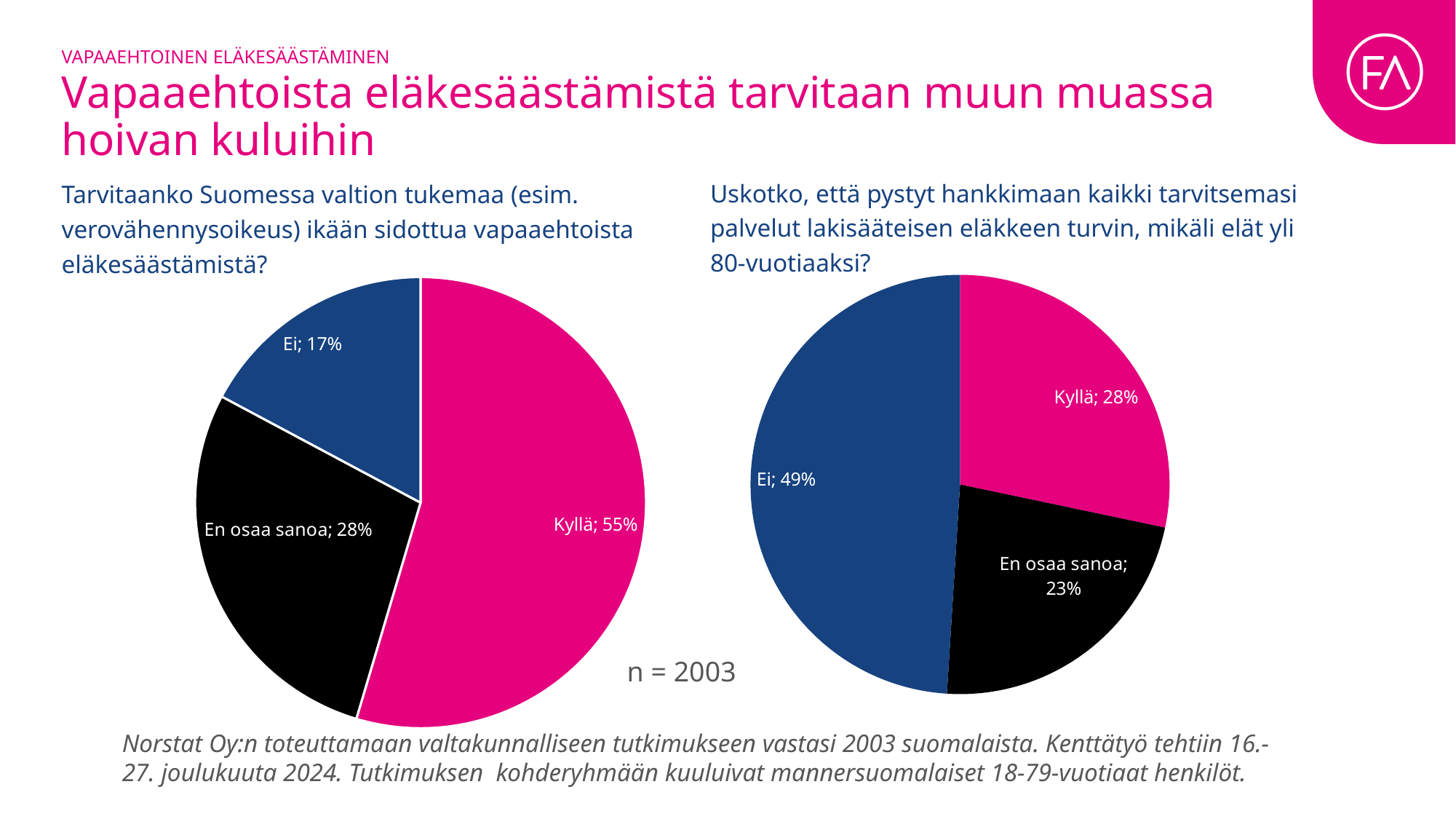
In the right pie chart (Uskotko, että pystyt hankkimaan kaikki tarvitsemasi palvelut...), what share answered Ei? 49% In the left pie chart (Tarvitaanko Suomessa valtion tukemaa... eläkesäästämistä?), what share answered Kyllä? 55% In the left pie chart, what share answered Ei? 17% In the right pie chart, which is larger: the Ei share or the Kyllä share? Ei How many slices does the left pie chart have? 3 In the left pie chart, which answer has the largest share? Kyllä In the right pie chart, what share answered En osaa sanoa? 23% In the right pie chart, what share answered Kyllä? 28% In the left pie chart, what share answered En osaa sanoa? 28% In the left pie chart, what is the difference between the Kyllä share and the Ei share? 38 percentage points In the right pie chart, which answer has the smallest share? En osaa sanoa What type of chart is used on the right side of the slide? Pie chart